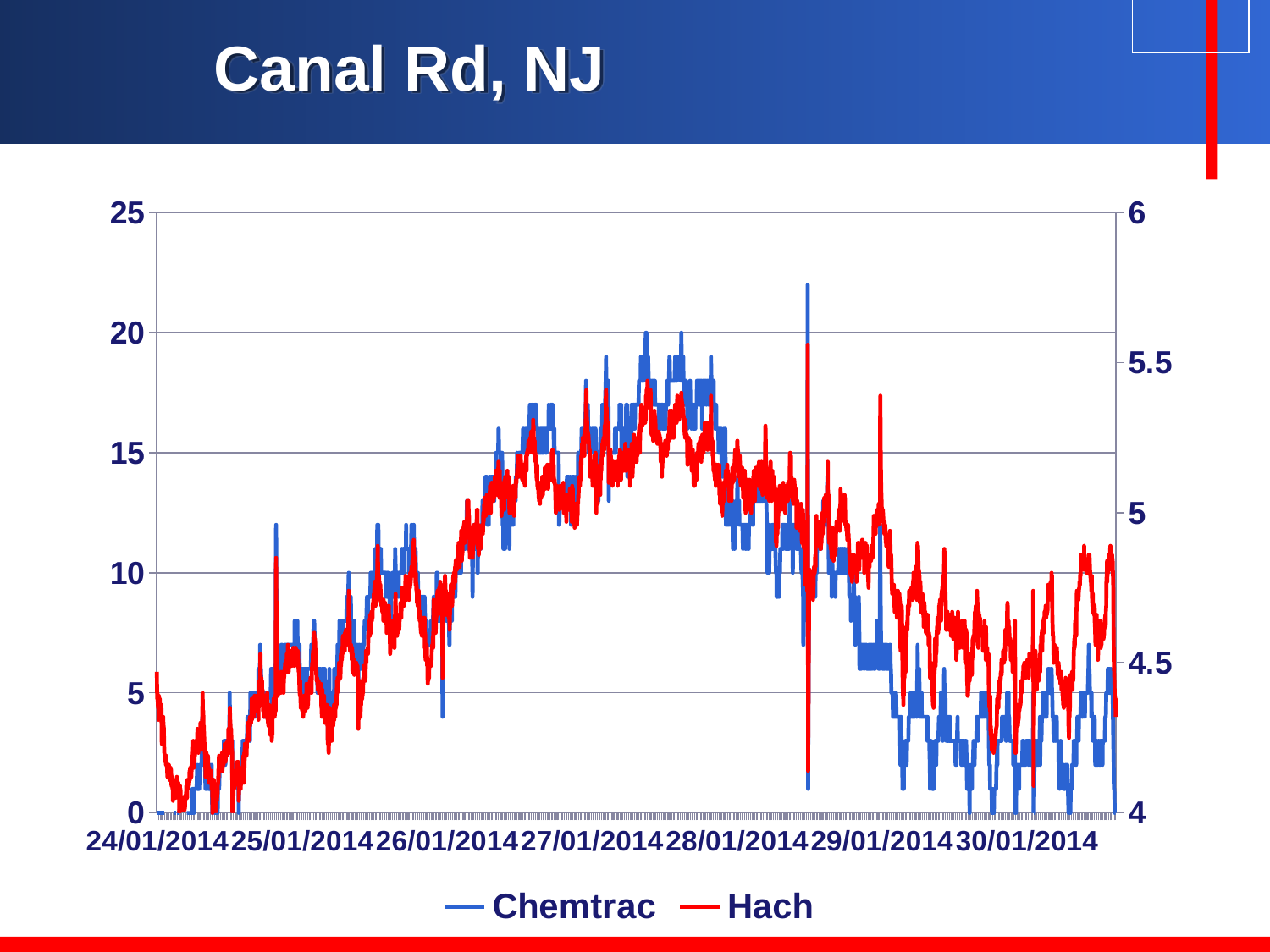
Between 28/01/2014 and 30/01/2014, does the Chemtrac line generally rise or fall? fall Which colour is used for the Hach series? red What is the highest value shown on the left vertical axis? 25 What is the lowest value shown on the right vertical axis? 4 Is the highest spike of the Chemtrac line greater or less than 20 on the left axis? greater What kind of chart is shown on the slide? line chart Is the Chemtrac value at the start of 24/01/2014 greater or less than 5 on the left axis? less How many date labels are shown along the x axis? 7 Between 24/01/2014 and 27/01/2014, does the Chemtrac line generally rise or fall? rise How many series does the legend list? 2 What are the two series named in the legend? Chemtrac and Hach